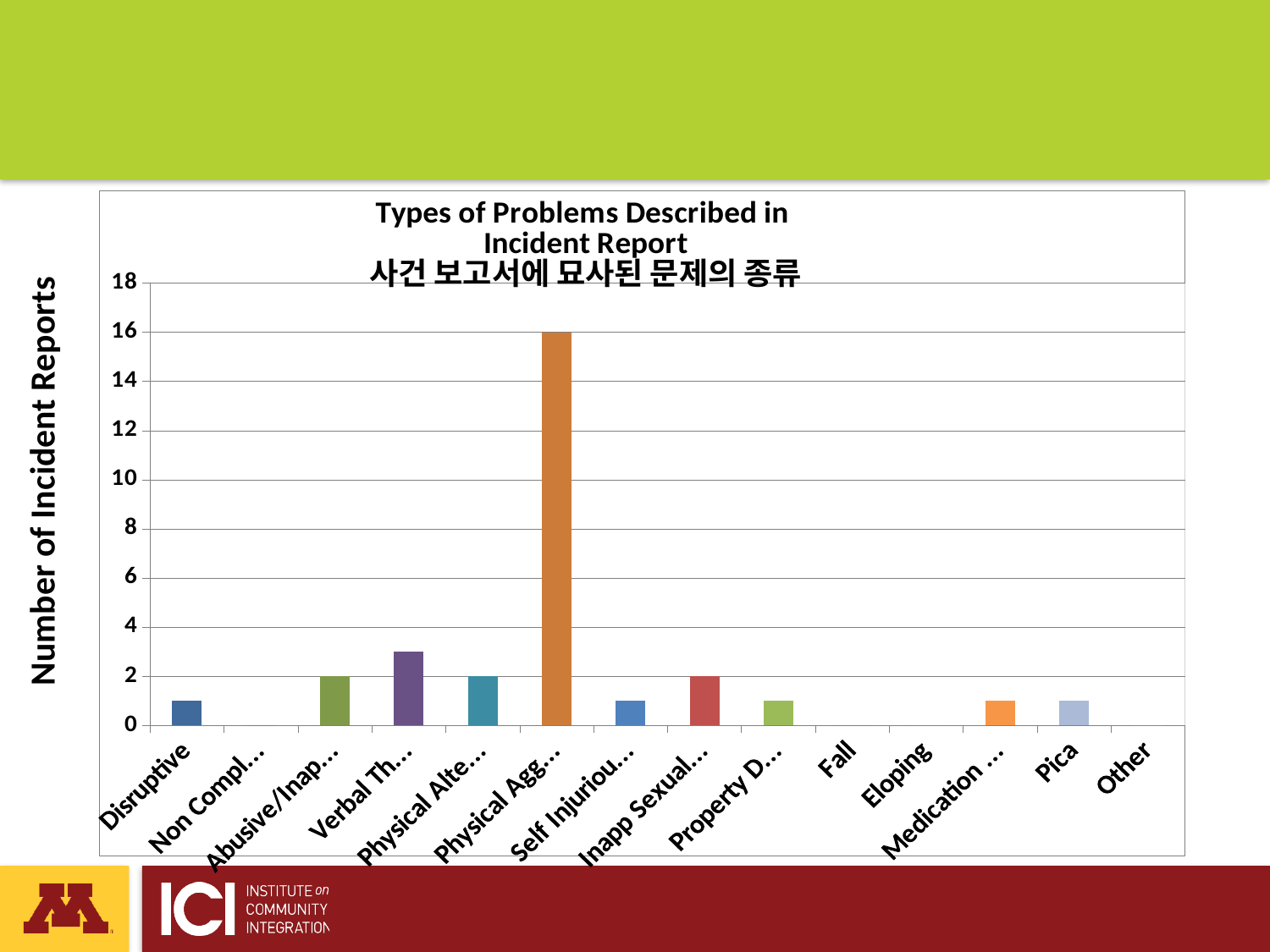
Is the value for Verbal Th… greater or less than 2? greater How many categories are shown on the x axis of the chart? 14 Is the value for Disruptive greater or less than 2? less What is the number of incident reports for Eloping? 0 What is the number of incident reports for Physical Agg…? 16 Which is larger, the value for Physical Agg… or the value for Pica? Physical Agg… What is the number of incident reports for Abusive/Inap…? 2 What is the difference between the value for Physical Agg… and the value for Abusive/Inap…? 14 What is the label of the vertical axis of the chart? Number of Incident Reports What is the number of incident reports for Fall? 0 What kind of chart is shown on the slide? bar chart Which category has the highest number of incident reports? Physical Agg…